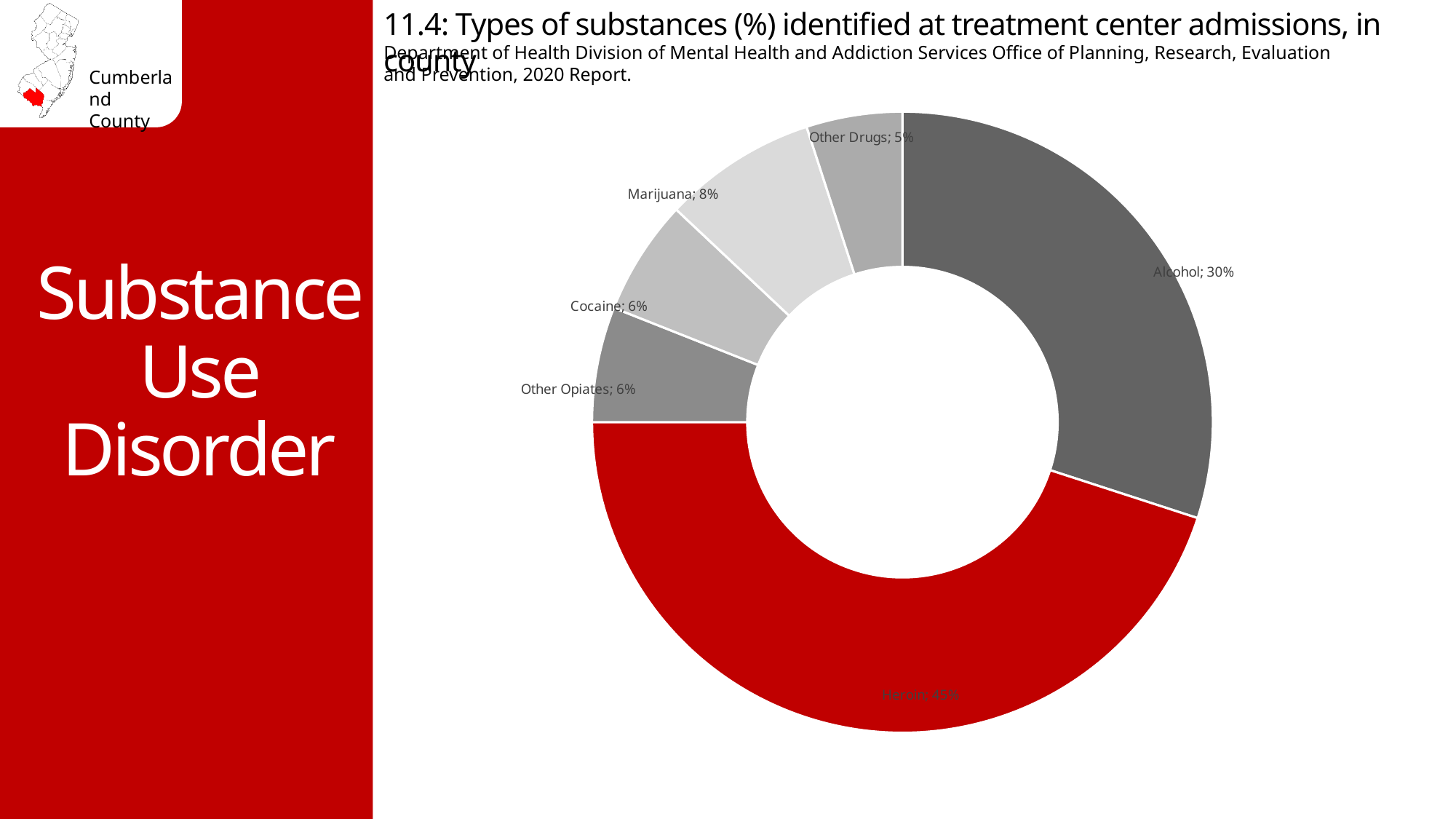
What percentage of treatment center admissions is attributed to Heroin? 45% Which has a larger share, Marijuana or Cocaine? Marijuana What percentage of treatment center admissions is attributed to Alcohol? 30% Which slice of the chart is colored red? Heroin How many substance categories are shown in the chart? 6 What is the combined percentage of Other Opiates and Cocaine? 12% What percentage is shown for Marijuana? 8% What percentage is shown for Other Drugs? 5% Which substance has the largest share of treatment center admissions? Heroin What type of chart is used on this slide? Doughnut (pie) chart Which substance has the smallest share of treatment center admissions? Other Drugs What is the difference in percentage points between Heroin and Alcohol? 15